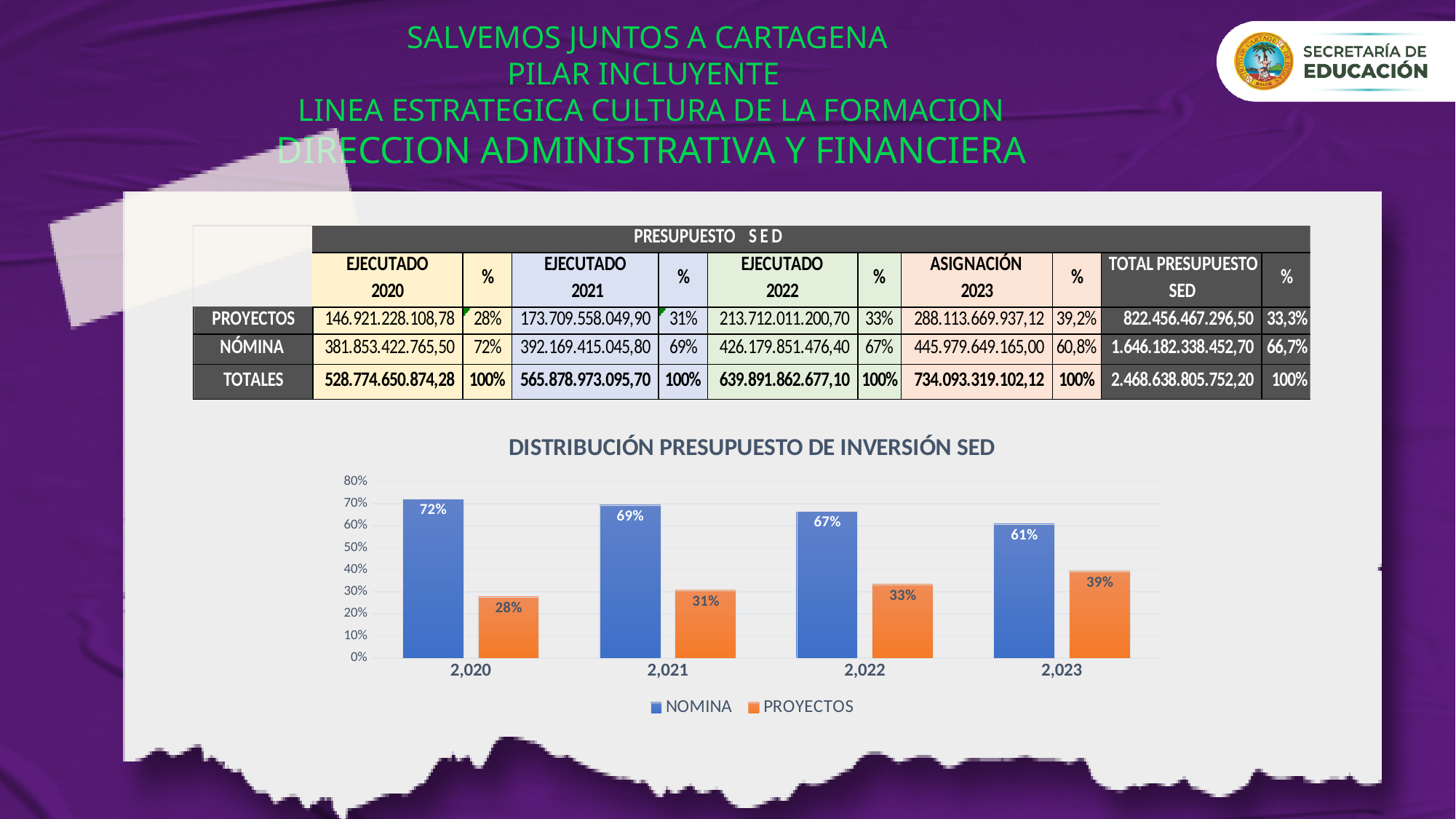
In which year is the NOMINA value highest? 2,020 What is the value for NOMINA in 2,022? 67% What is the difference between the NOMINA and PROYECTOS values in 2,023? 22% How many series does the chart legend list? 2 How many years are shown on the x axis of the chart? 4 Which is larger in 2,022, NOMINA or PROYECTOS? NOMINA What is the value for PROYECTOS in 2,023? 39% What kind of chart is shown on the slide? Bar chart Does the PROYECTOS value rise or fall from 2,020 to 2,023? Rise What is the value for PROYECTOS in 2,021? 31% In which year is the PROYECTOS value lowest? 2,020 What is the value for NOMINA in 2,020? 72%